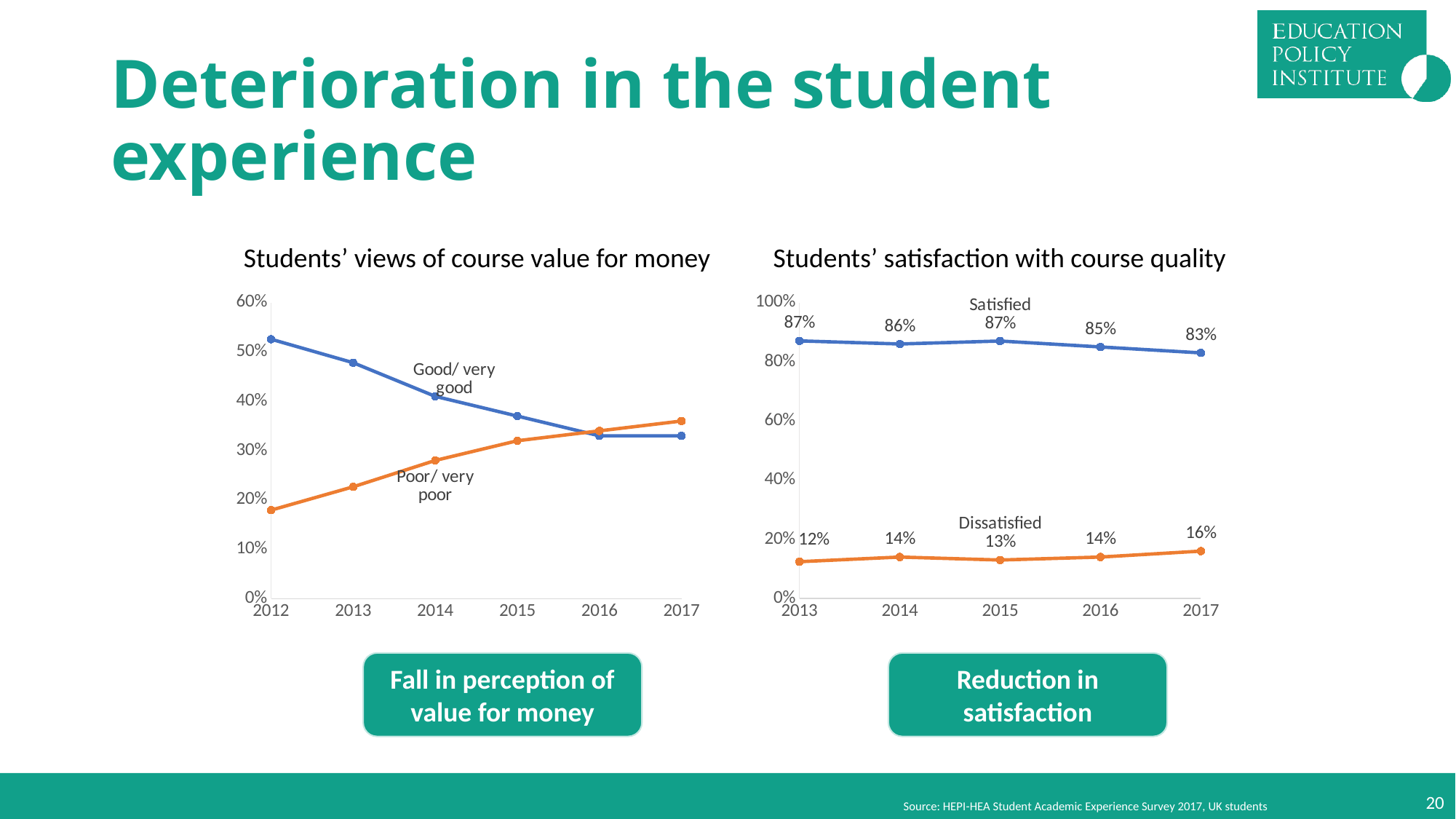
In the 'Students' satisfaction with course quality' chart, is the Dissatisfied value higher in 2014 or 2015? 2014 In the 'Students' satisfaction with course quality' chart, which year has the lowest Satisfied value? 2017 How many years are shown on the x axis of the 'Students' satisfaction with course quality' chart? 5 In the 'Students' satisfaction with course quality' chart, which year has the highest Dissatisfied value? 2017 In the 'Students' views of course value for money' chart, does the Good/ very good line rise or fall from 2012 to 2017? Fall How many series are plotted in the 'Students' views of course value for money' chart? 2 In the 'Students' views of course value for money' chart, is the Poor/ very poor value for 2012 greater or less than 30%? less What type of chart is 'Students' satisfaction with course quality'? Line chart In the 'Students' satisfaction with course quality' chart, what is the Dissatisfied value for 2013? 12% In the 'Students' views of course value for money' chart, is the Good/ very good value for 2012 greater or less than 40%? greater In the 'Students' satisfaction with course quality' chart, what is the difference between the Satisfied values for 2013 and 2017? 4% In the 'Students' satisfaction with course quality' chart, what is the Satisfied value for 2017? 83%